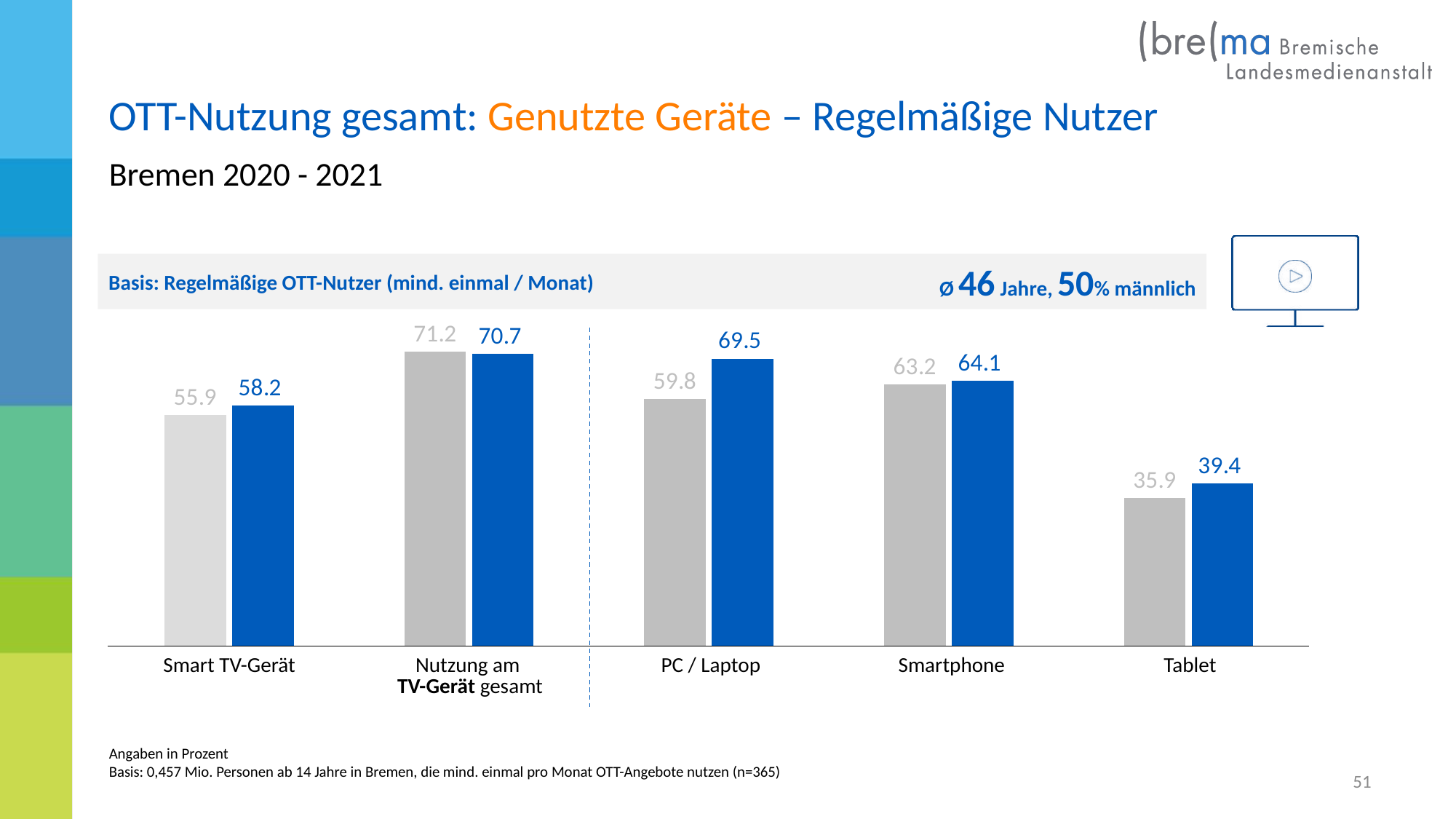
What is the difference between the blue and grey bar values for PC / Laptop? 9.7 What is the value of the blue bar for Smart TV-Gerät? 58.2 How many device categories are shown on the x axis? 5 What is the value of the blue bar for PC / Laptop? 69.5 For Nutzung am TV-Gerät gesamt, which bar is larger, the grey bar or the blue bar? the grey bar Which category has the highest blue bar value? Nutzung am TV-Gerät gesamt What is the difference between the blue and grey bar values for Tablet? 3.5 What kind of chart is shown on the slide? bar chart What is the value of the grey bar for Tablet? 35.9 What is the value of the grey bar for Smartphone? 63.2 According to the note below the chart, in what unit are the values given? Prozent Which category has the lowest grey bar value? Tablet